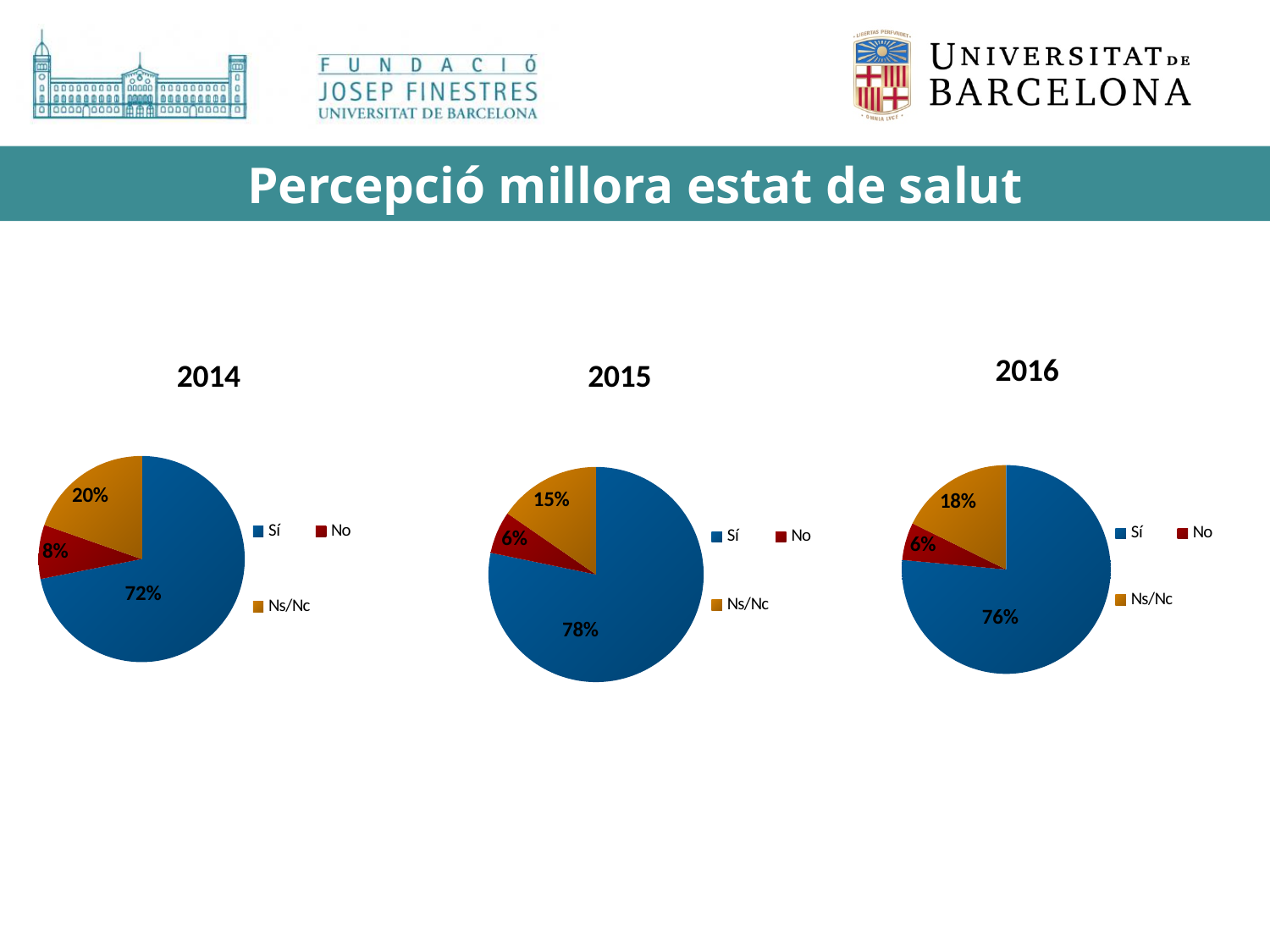
In the 2014 pie chart, which is larger, the No slice or the Ns/Nc slice? Ns/Nc What kind of chart is used for the 2014 data? Pie chart In the 2016 pie chart, what is the difference between the Sí share and the Ns/Nc share? 58% In the 2016 pie chart, what colour is the Sí slice? Blue In the 2014 pie chart, what share is labelled for Sí? 72% How many entries does the legend of the 2016 chart list? 3 In the 2016 pie chart, what share is labelled for No? 6% In the 2015 pie chart, which category has the smallest slice? No In the 2015 pie chart, what share is labelled for Ns/Nc? 15% How many slices does the 2015 pie chart have? 3 What is the title of the 2015 chart? 2015 In the 2014 pie chart, which category has the largest slice? Sí